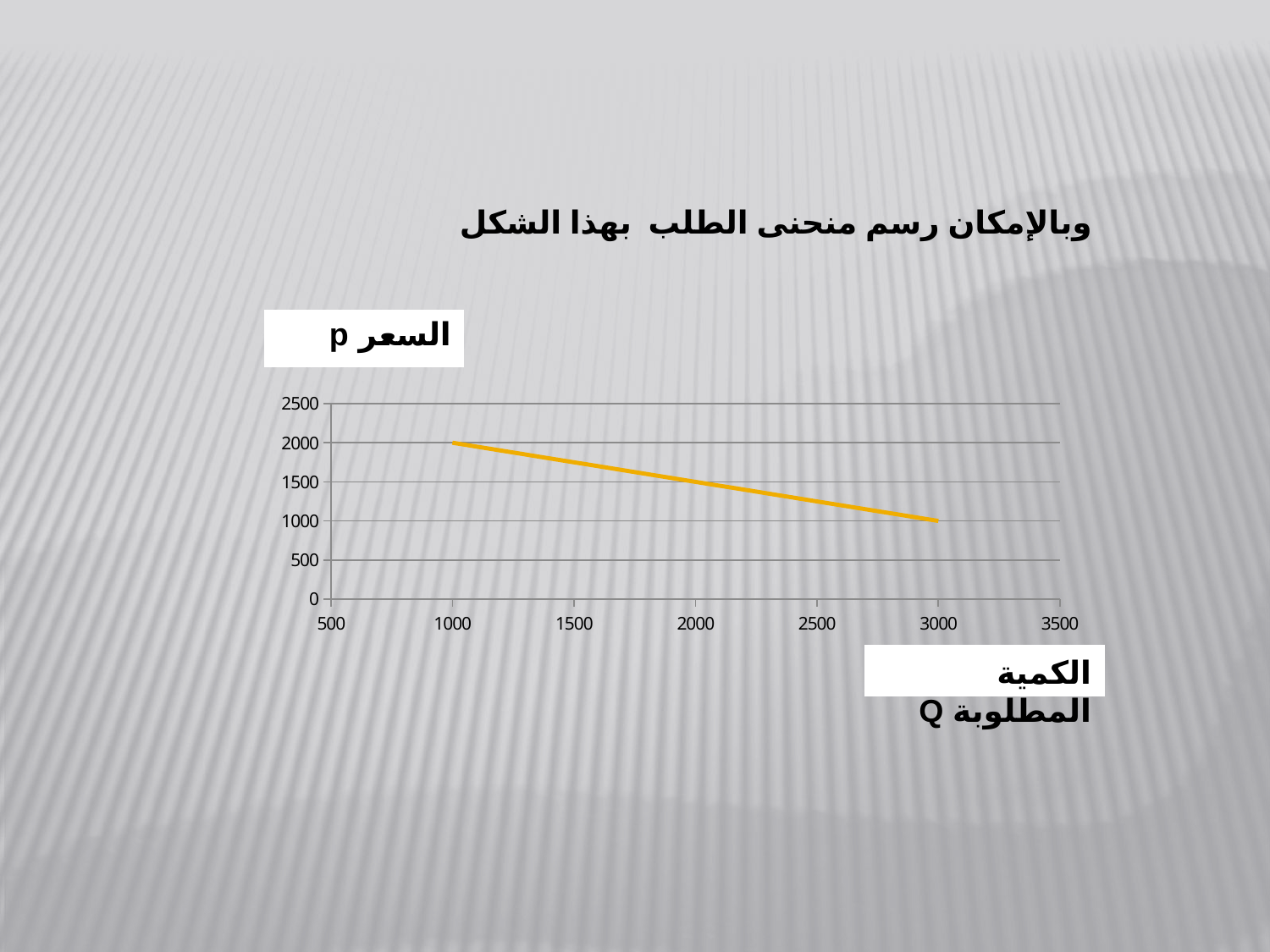
Which quantity has the higher price, 1000 or 3000? 1000 Does the demand line rise or fall as the quantity on the x axis increases? fall Is the price at a quantity of 2000 greater or less than 1000? greater What is the difference between the price at quantity 1000 and the price at quantity 3000? 1000 What label is given to the x axis of the chart? الكمية المطلوبة Q What is the price (p) at a quantity of 3000? 1000 What is the highest value shown on the y axis? 2500 What is the price (p) at a quantity of 1000? 2000 Is the price at a quantity of 2000 greater or less than 2000? less What kind of chart is shown on the slide? line chart